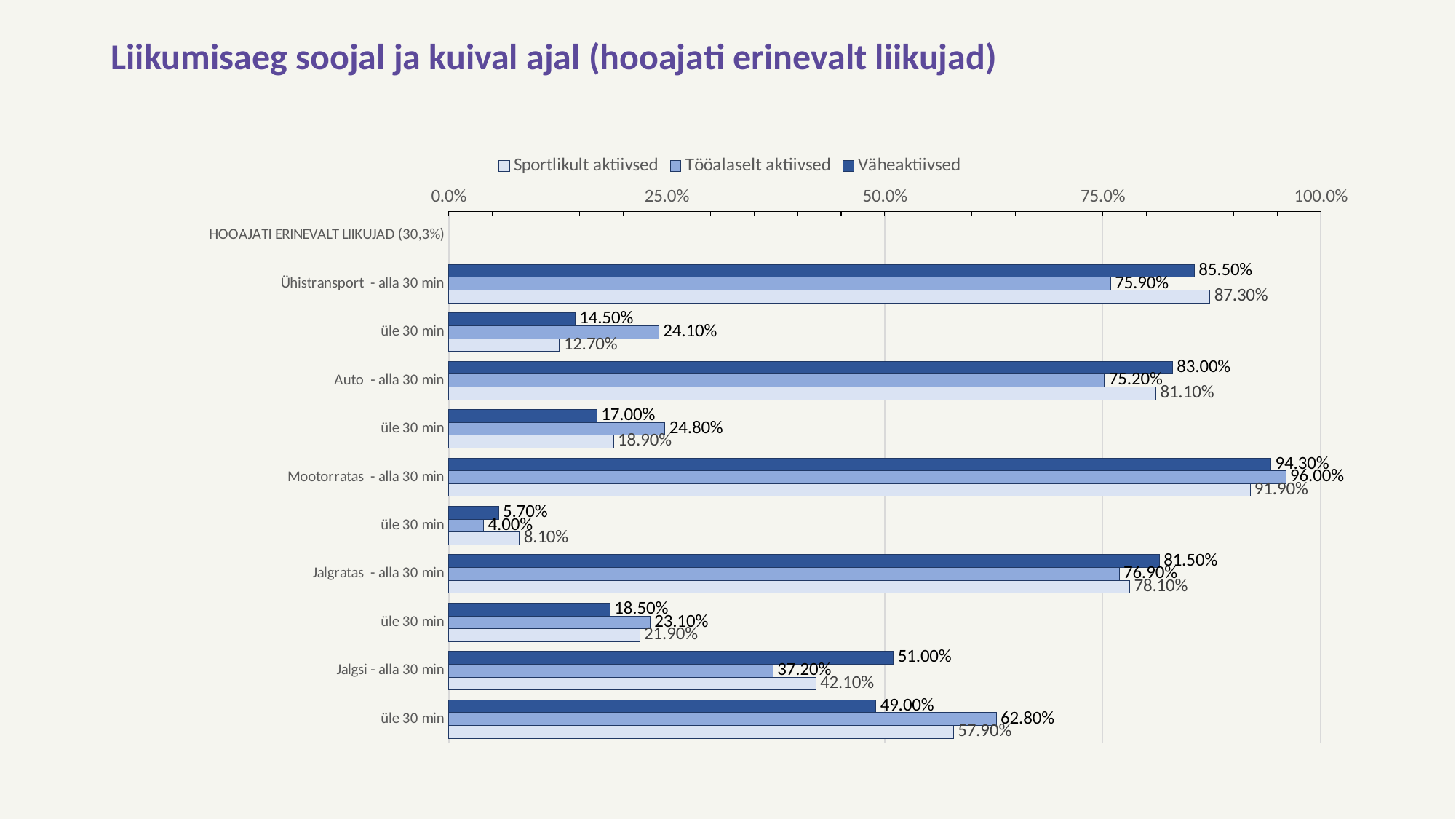
What is the value for Väheaktiivsed for Ühistransport - alla 30 min? 85.50% How many series does the legend list? 3 Which series has the lowest value for Jalgsi - alla 30 min? Tööalaselt aktiivsed What is the difference between the Väheaktiivsed and Tööalaselt aktiivsed values for Jalgsi - alla 30 min? 13.80% For Auto - alla 30 min, which is larger: the Väheaktiivsed value or the Sportlikult aktiivsed value? Väheaktiivsed What is the value for Tööalaselt aktiivsed for Jalgsi - üle 30 min? 62.80% Is the Sportlikult aktiivsed value for Jalgsi - üle 30 min greater or less than 50.0%? greater What is the value for Sportlikult aktiivsed for Mootorratas - üle 30 min? 8.10% What is the value for Tööalaselt aktiivsed for Auto - üle 30 min? 24.80% Which series has the highest value for Mootorratas - alla 30 min? Tööalaselt aktiivsed What kind of chart is shown on the slide? bar chart Which series is shown with the darkest blue bars? Väheaktiivsed